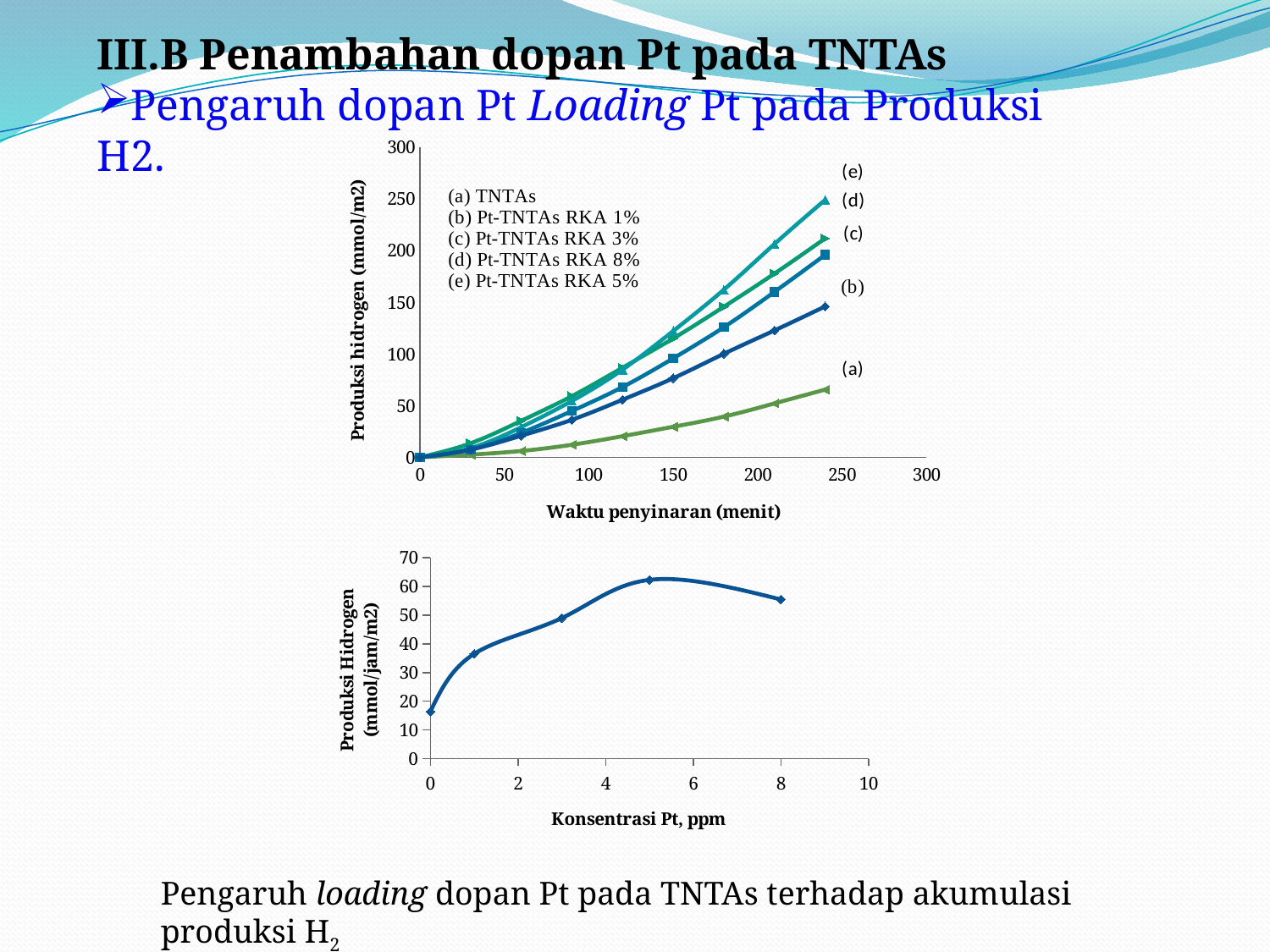
In the top chart, what does the legend say series (e) is? Pt-TNTAs RKA 5% In the top chart, which series has the lowest value at 240 minutes? (a) In the bottom chart, is the value at 0 ppm greater or less than 20? less What kind of chart is the top chart (hydrogen production versus irradiation time)? line chart In the top chart, which is larger at 240 minutes: series (b) or series (c)? (c) In the bottom chart (hydrogen production versus Pt concentration), how many data points are plotted? 5 In the top chart, is the value of series (e) at 240 minutes greater or less than 200? greater In the top chart, how many series does the legend list? 5 In the top chart, is the value of series (a) at 240 minutes greater or less than 100? less In the bottom chart, at which Pt concentration is hydrogen production highest? 5 ppm In the bottom chart, does the value rise or fall from 5 ppm to 8 ppm? fall In the top chart, which series has the highest value at 240 minutes? (e)